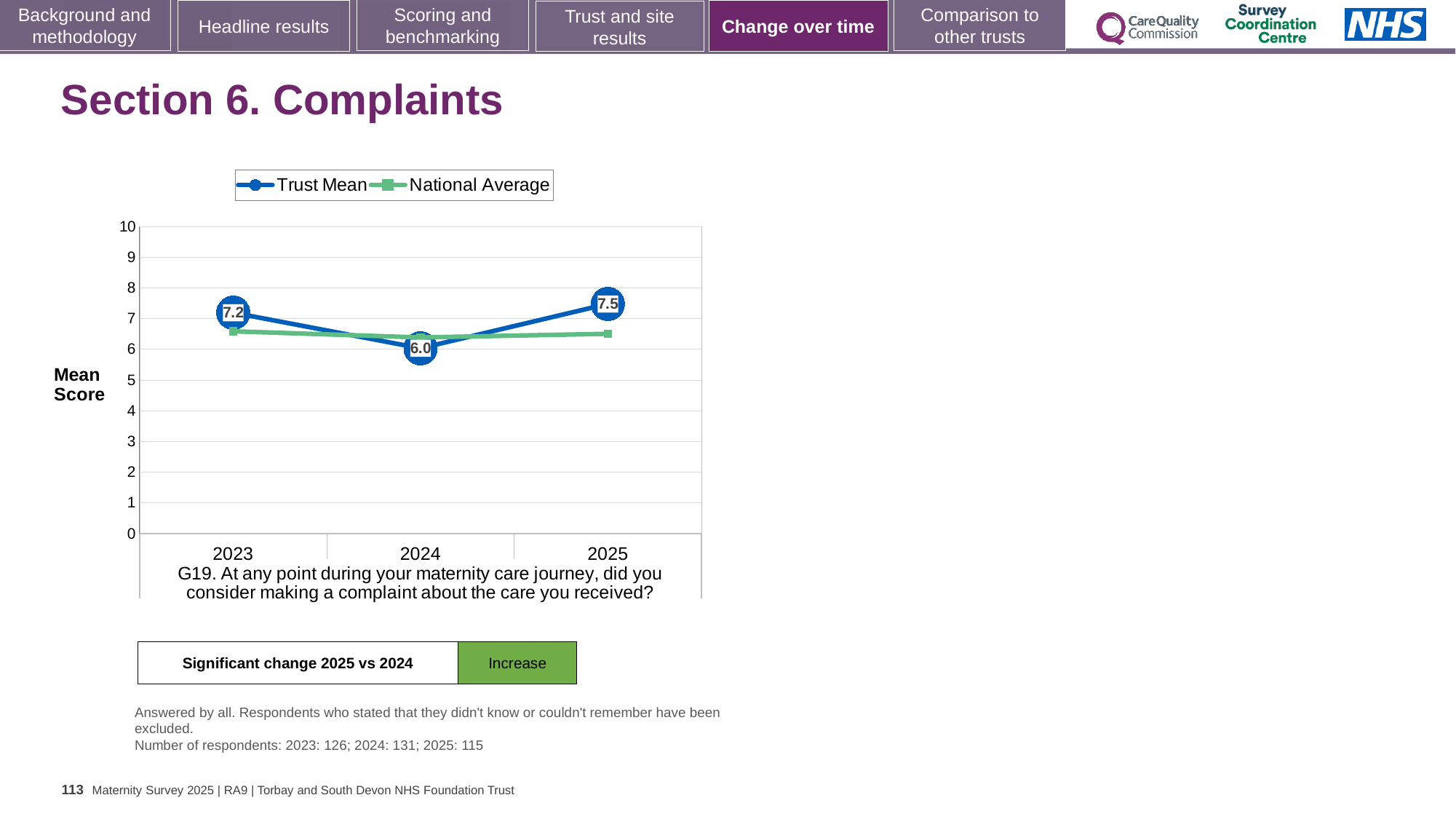
What is the Trust Mean score for 2024? 6.0 In which year is the Trust Mean score highest? 2025 Between 2024 and 2025, does the Trust Mean rise or fall? rise In 2024, which is larger: the Trust Mean or the National Average? National Average What is the Trust Mean score for 2025? 7.5 What is the difference between the Trust Mean scores for 2023 and 2024? 1.2 In which year is the Trust Mean score lowest? 2024 How many series does the legend list? 2 What is the Trust Mean score for 2023? 7.2 Is the National Average value for 2025 greater or less than 6? greater What is the difference between the Trust Mean scores for 2025 and 2024? 1.5 Is the National Average value for 2023 greater or less than 7? less